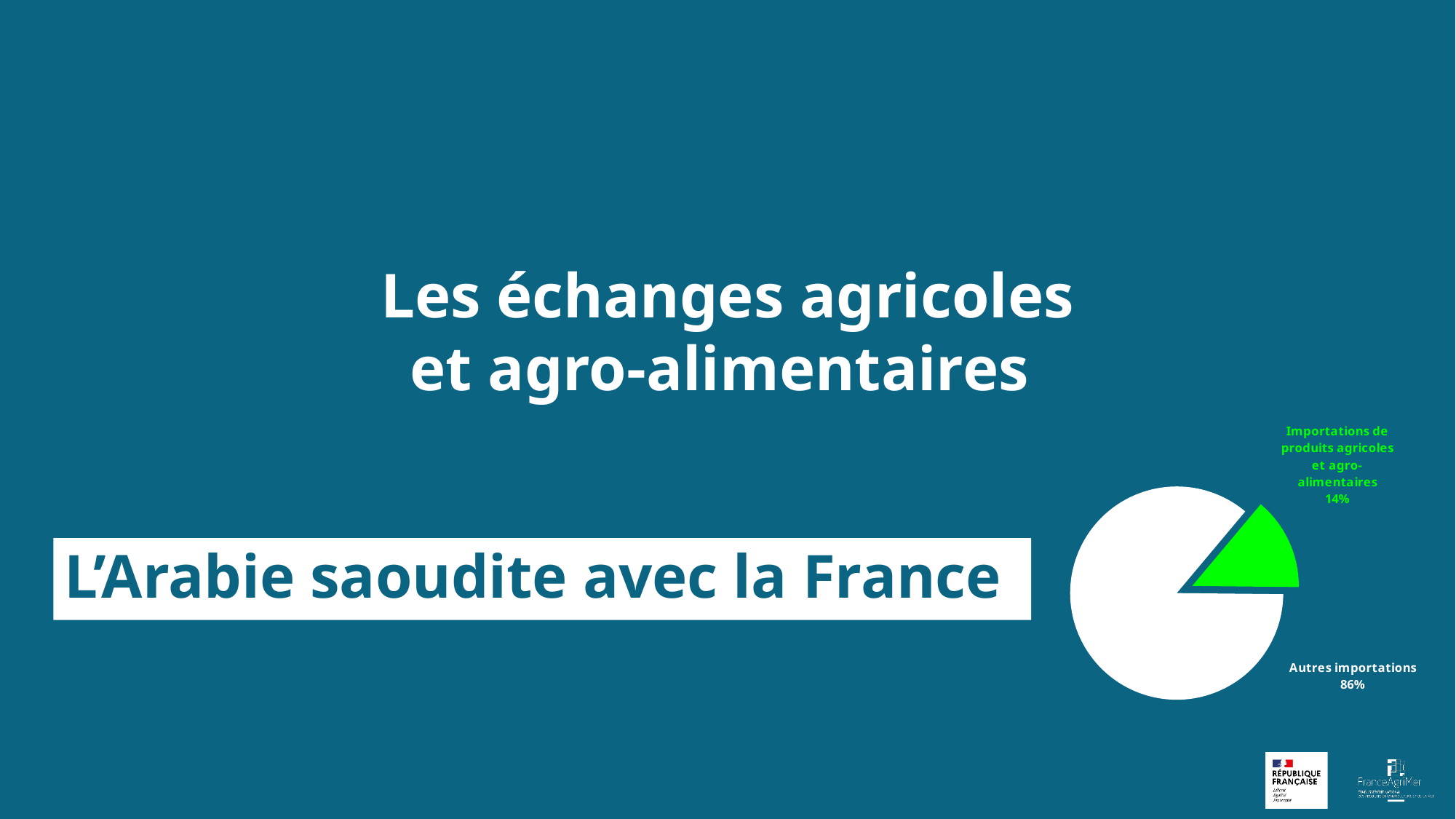
Which slice of the pie is the smallest? Importations de produits agricoles et agro-alimentaires What kind of chart is shown on the slide? pie chart Which is larger: the "Autres importations" slice or the "Importations de produits agricoles et agro-alimentaires" slice? Autres importations What share of the pie is labelled "Autres importations"? 86% How many slices does the pie chart have? 2 What share of the pie is labelled "Importations de produits agricoles et agro-alimentaires"? 14% What is the total of the two slice percentages shown on the pie chart? 100% What colour is the "Autres importations" slice? white Which slice of the pie is the largest? Autres importations What is the difference in percentage points between the "Autres importations" slice and the "Importations de produits agricoles et agro-alimentaires" slice? 72 What colour is the "Importations de produits agricoles et agro-alimentaires" slice? green